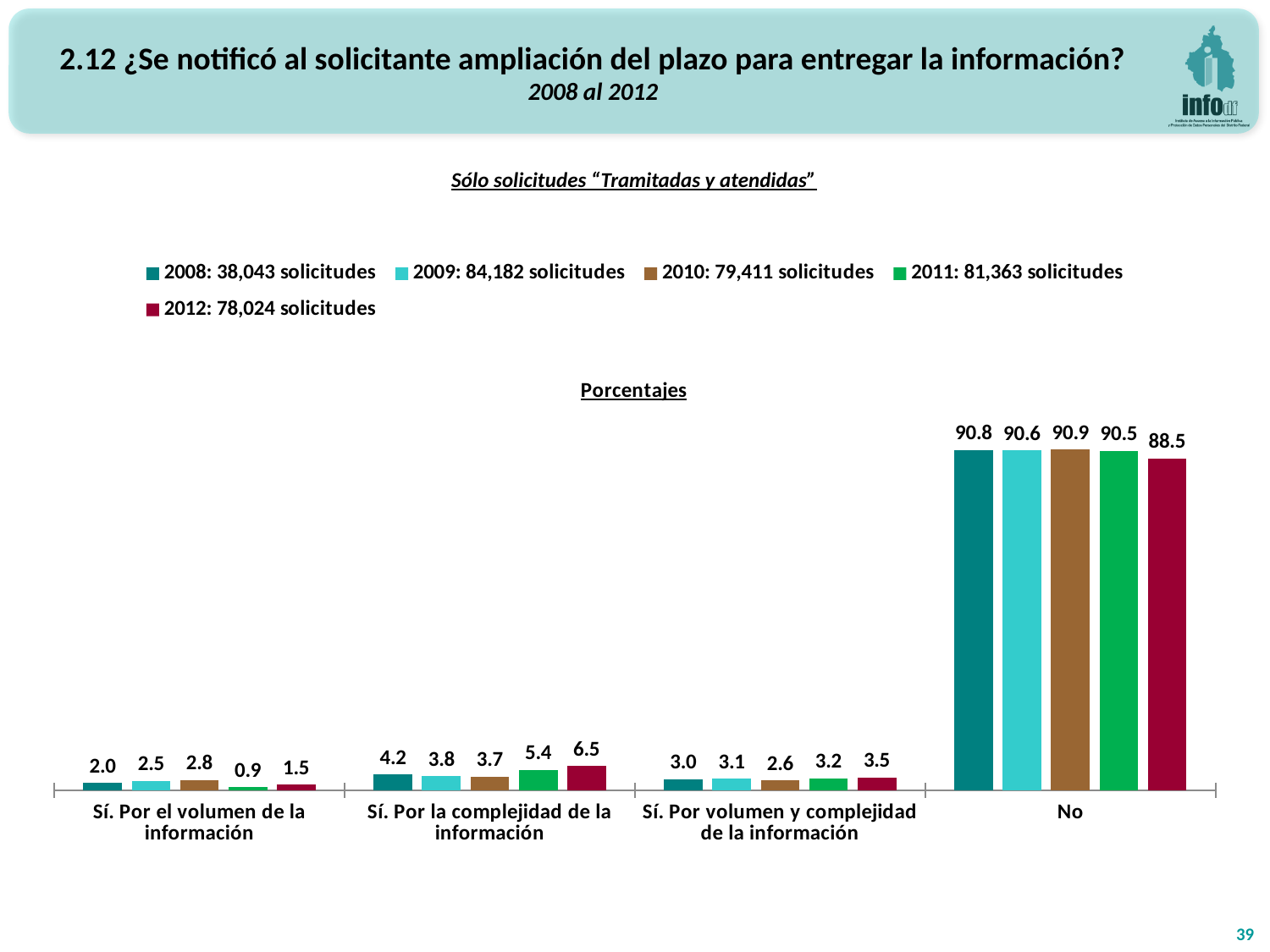
What is the value for 2011 in the "Sí. Por el volumen de la información" category? 0.9 What is the difference between the 2010 and 2012 values in the "No" category? 2.4 According to the legend, how many solicitudes were there in 2009? 84,182 Which is larger: the 2010 value or the 2011 value in the "Sí. Por volumen y complejidad de la información" category? 2011 How many categories are shown on the x axis? 4 What is the value for 2012 in the "No" category? 88.5 Which year has the lowest value in the "Sí. Por el volumen de la información" category? 2011 What kind of chart is shown on the slide? bar chart What is the value for 2008 in the "Sí. Por la complejidad de la información" category? 4.2 How many series does the legend list? 5 What is the difference between the 2012 and 2008 values in the "Sí. Por la complejidad de la información" category? 2.3 Which year has the highest value in the "Sí. Por la complejidad de la información" category? 2012